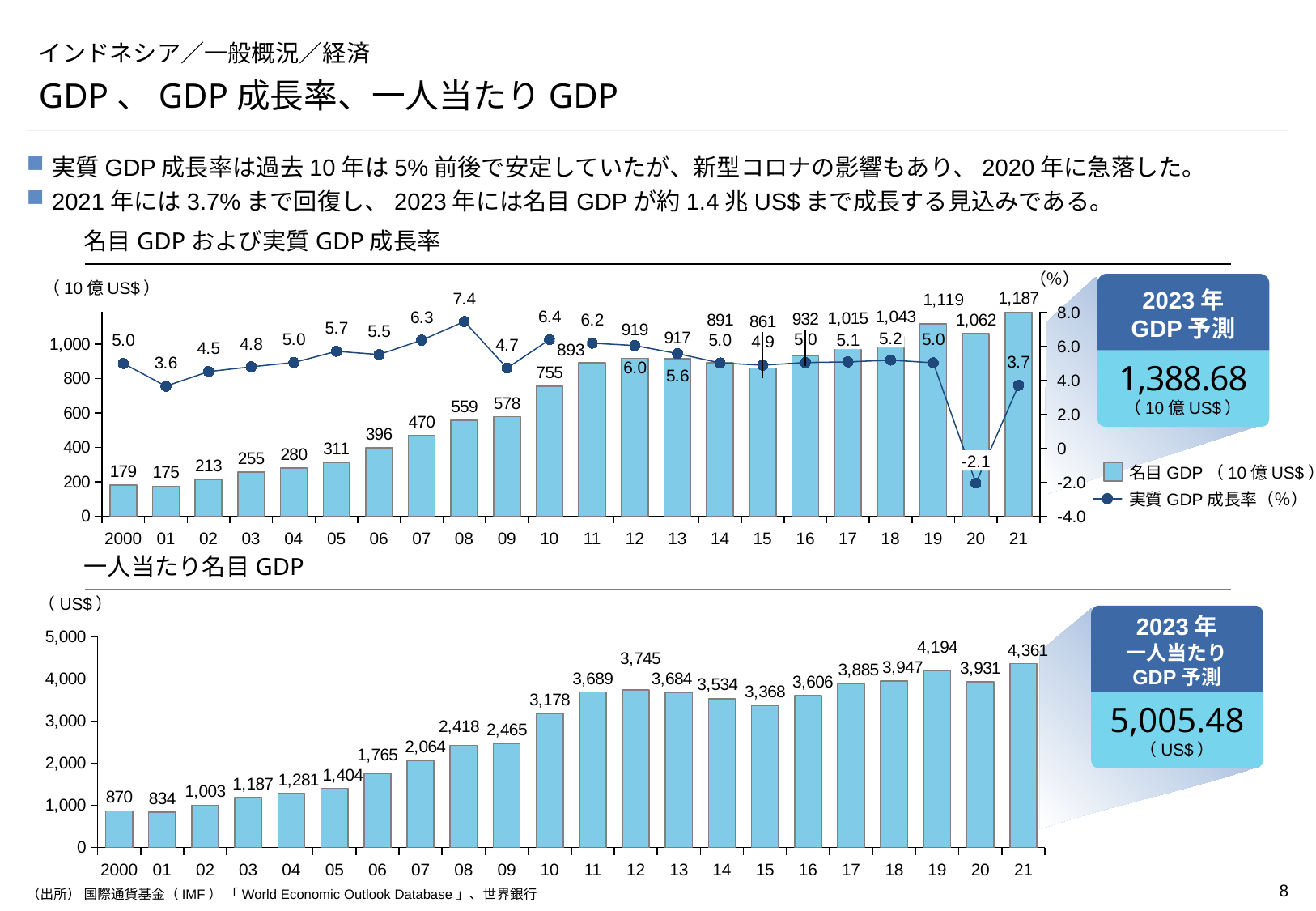
In the bottom chart (一人当たり名目GDP), which year has the larger value, 2012 or 2013? 2012 In the top chart (名目GDPおよび実質GDP成長率), what is the real GDP growth rate for 2008? 7.4 In the top chart (名目GDPおよび実質GDP成長率), which year has the highest nominal GDP? 21 In the bottom chart (一人当たり名目GDP), which year has the highest value? 21 How many series does the legend of the top chart (名目GDPおよび実質GDP成長率) list? 2 In the top chart (名目GDPおよび実質GDP成長率), by how much did nominal GDP increase from 2020 to 2021? 125 In the bottom chart (一人当たり名目GDP), what is the difference between the 2021 and 2020 values? 430 What kind of chart is the bottom chart (一人当たり名目GDP)? bar chart In the top chart (名目GDPおよび実質GDP成長率), which year has the lowest real GDP growth rate? 20 In the top chart (名目GDPおよび実質GDP成長率), what is the nominal GDP value for 2010? 755 In the bottom chart (一人当たり名目GDP), what is the value for 2019? 4,194 How many years are plotted in the bottom chart (一人当たり名目GDP)? 22